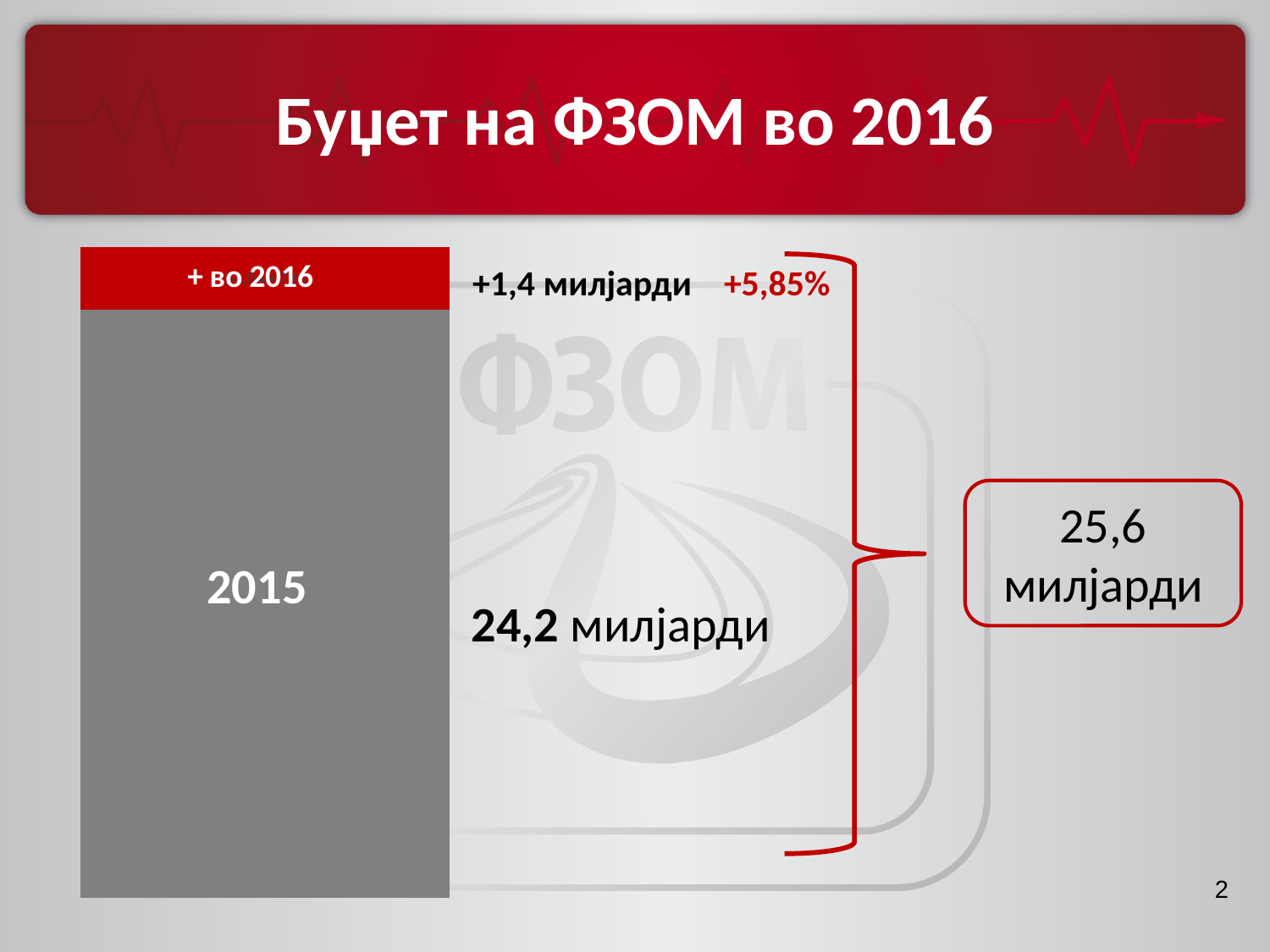
How many segments does the stacked bar have? 2 Which segment of the bar is the smallest? + во 2016 What value is shown for the segment labelled "+ во 2016"? +1,4 милијарди What value is shown for the 2015 segment of the bar? 24,2 милијарди What is the total of the stacked bar, as shown by the bracket on the right? 25,6 милијарди What is the title of the chart on the slide? Буџет на ФЗОМ во 2016 Which segment of the bar is larger, the 2015 segment or the "+ во 2016" segment? 2015 What colour is the segment labelled "+ во 2016"? red What kind of chart is shown on the slide? bar chart What percentage increase is shown for the "+ во 2016" segment? +5,85%